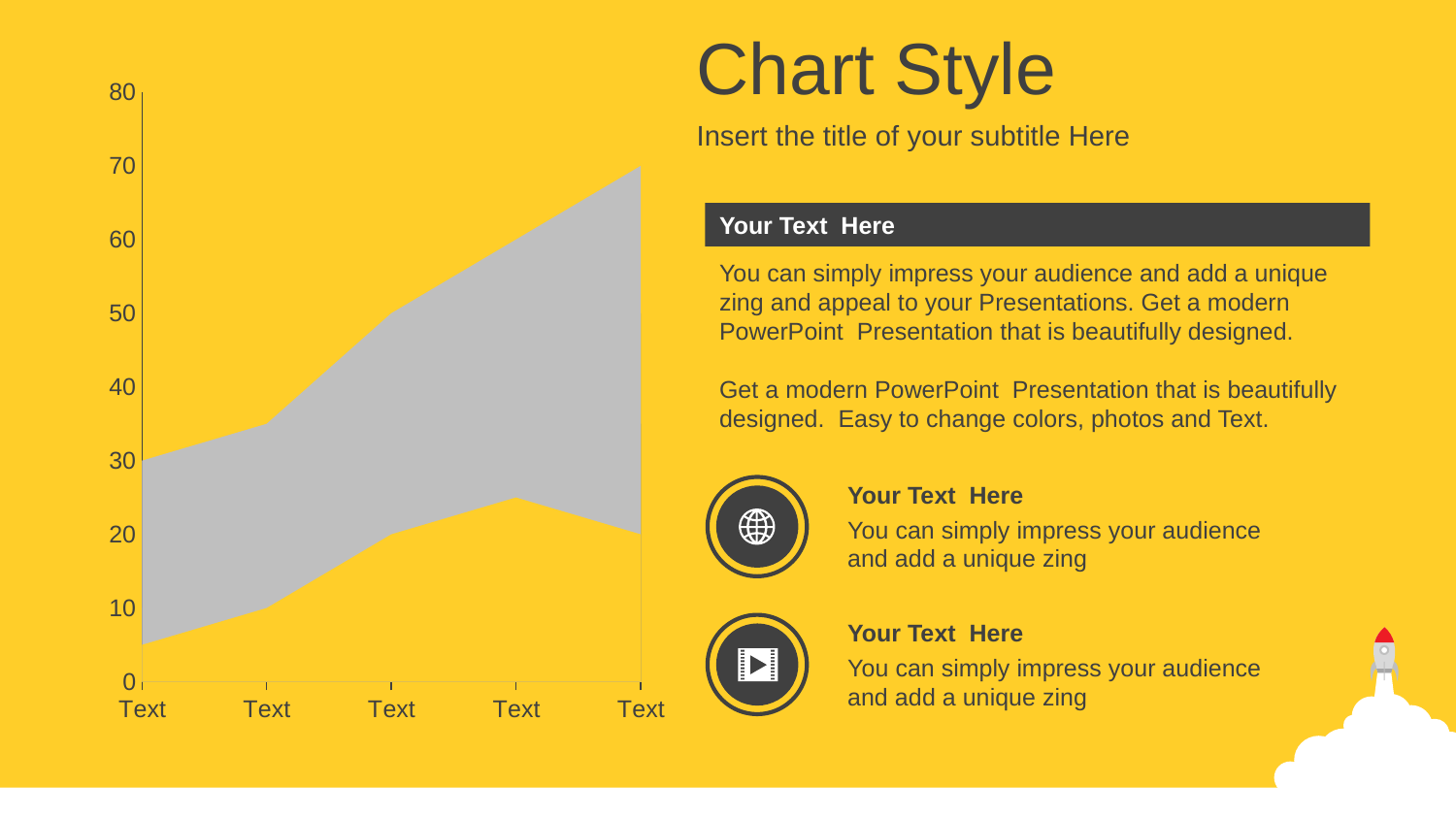
What kind of chart is shown on the slide? area chart What label is used for each category on the x axis of the chart? Text Does the upper edge of the shaded area rise or fall from left to right along the x axis? rise Is the upper edge of the shaded area at the first category greater or less than 40? less Is the lower edge of the shaded area at the first category greater or less than 10? less Is the upper edge of the shaded area at the middle (third) category greater or less than 40? greater How many categories are shown along the x axis of the chart? 5 What is the highest value shown on the y axis of the chart? 80 At which category does the upper edge of the shaded area reach its highest point? the last (fifth) category Which is higher: the upper edge of the shaded area at the first category or at the last category? the last category